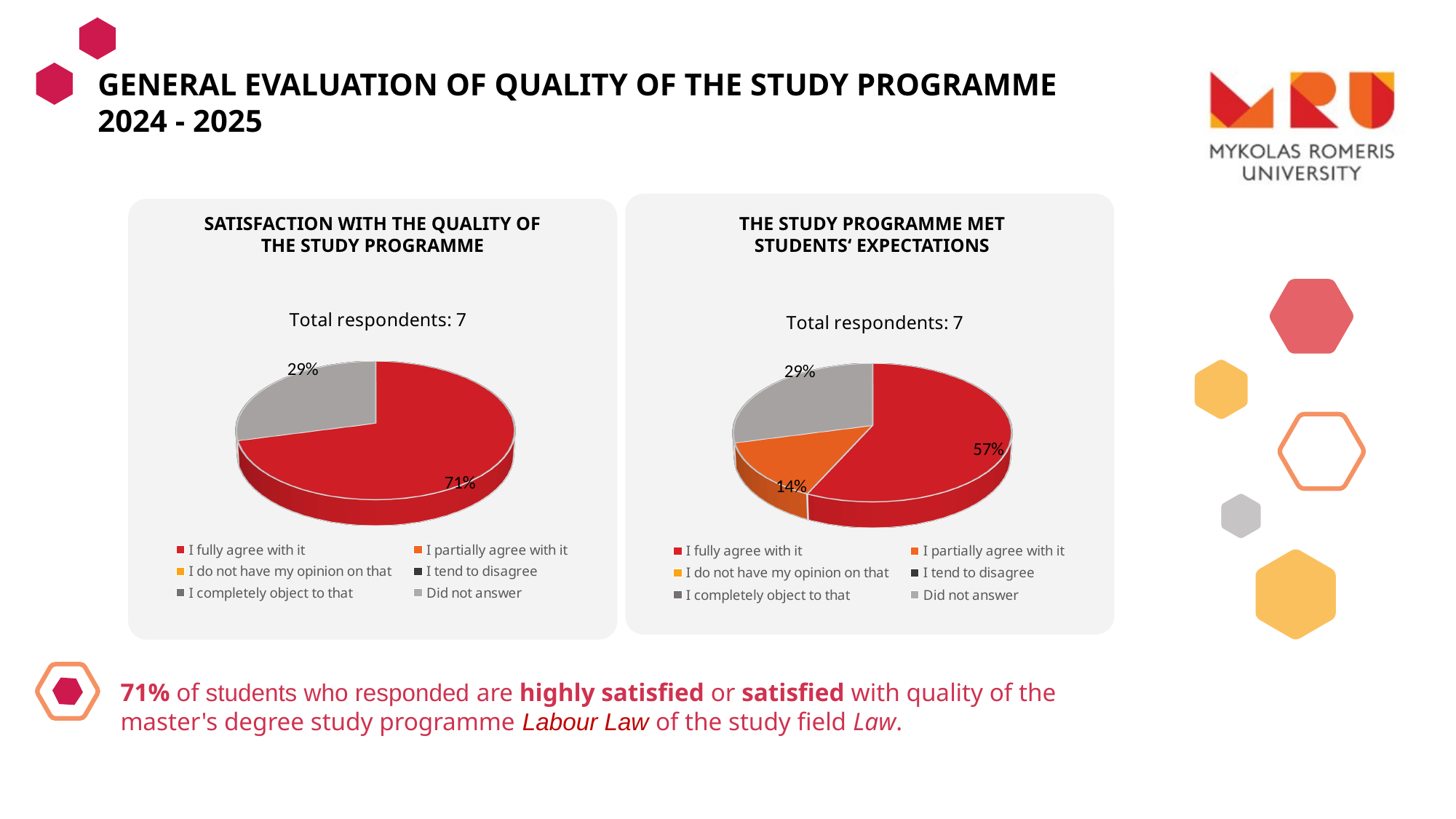
In the 'The study programme met students' expectations' chart, what is the difference between the 'I fully agree with it' share and the 'Did not answer' share? 28% In the 'The study programme met students' expectations' chart, what share of respondents did not answer? 29% In the 'Satisfaction with the quality of the study programme' chart, what share of respondents did not answer? 29% In the 'Satisfaction with the quality of the study programme' chart, which is larger: 'I fully agree with it' or 'Did not answer'? I fully agree with it How many entries does the legend of the 'Satisfaction with the quality of the study programme' chart list? 6 In the 'Satisfaction with the quality of the study programme' chart, what share of respondents chose 'I fully agree with it'? 71% In the 'The study programme met students' expectations' chart, what share of respondents chose 'I fully agree with it'? 57% In the 'The study programme met students' expectations' chart, which response has the largest slice? I fully agree with it How many slices does the pie in the 'The study programme met students' expectations' chart have? 3 What type of chart is used in the 'Satisfaction with the quality of the study programme' panel? Pie chart In the 'The study programme met students' expectations' chart, what share of respondents chose 'I partially agree with it'? 14% In the 'The study programme met students' expectations' chart, which response has the smallest slice? I partially agree with it